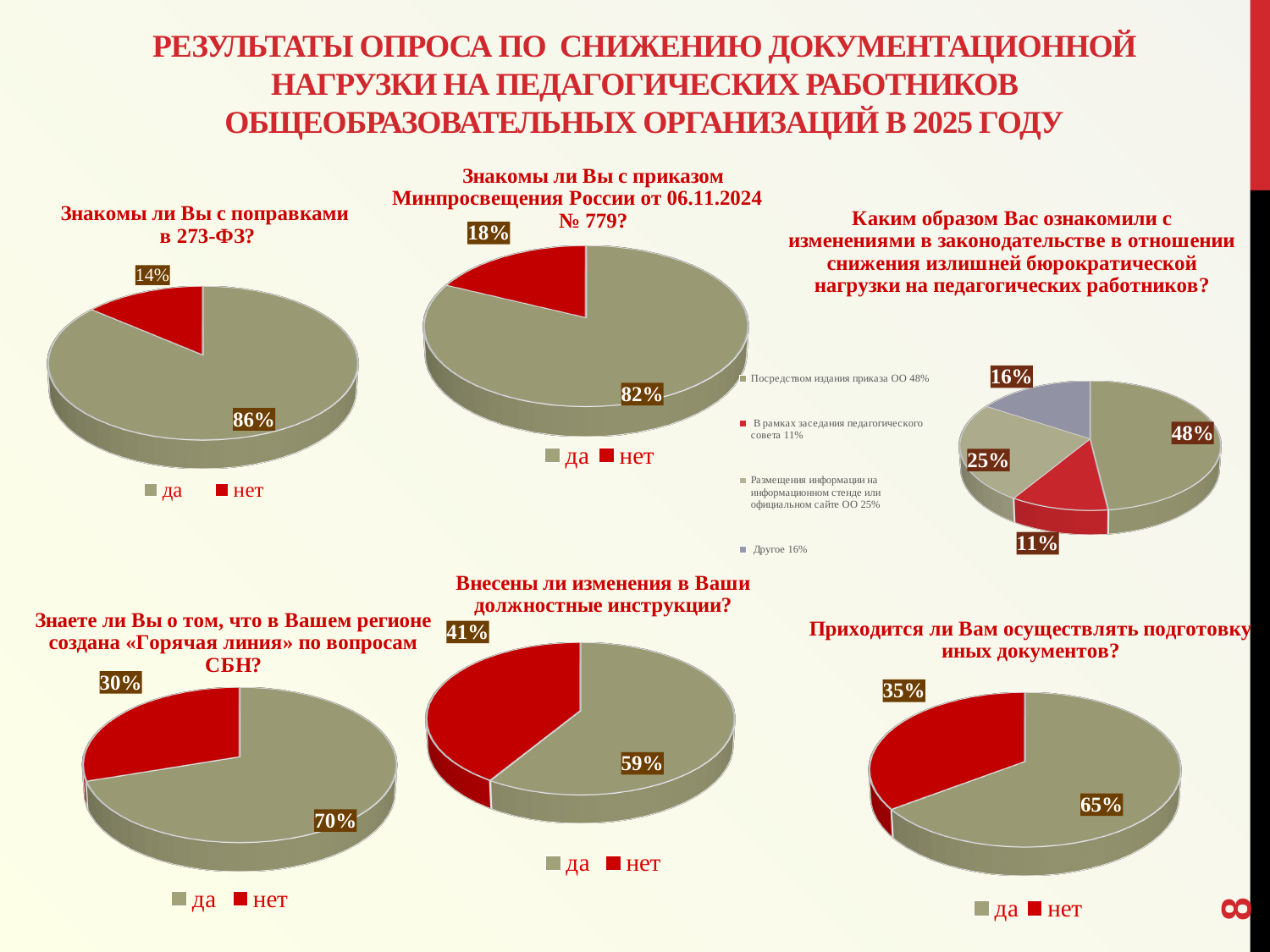
In the chart 'Знакомы ли Вы с приказом Минпросвещения России от 06.11.2024 № 779?', what share of respondents answered 'нет'? 18% In the chart 'Знакомы ли Вы с поправками в 273-ФЗ?', what share of respondents answered 'да'? 86% In the chart 'Приходится ли Вам осуществлять подготовку иных документов?', which answer has the larger share, 'да' or 'нет'? да What type of chart is used for 'Внесены ли изменения в Ваши должностные инструкции?'? Pie chart In the chart 'Внесены ли изменения в Ваши должностные инструкции?', what is the difference between the 'да' and 'нет' shares? 18% In the chart 'Приходится ли Вам осуществлять подготовку иных документов?', what share answered 'нет'? 35% In the chart 'Каким образом Вас ознакомили с изменениями в законодательстве...', which category has the largest share? Посредством издания приказа ОО How many entries does the legend of the chart 'Знакомы ли Вы с поправками в 273-ФЗ?' list? 2 How many categories does the chart 'Каким образом Вас ознакомили с изменениями в законодательстве...' show? 4 In the chart 'Каким образом Вас ознакомили с изменениями в законодательстве...', what is the share for 'Другое'? 16% In the chart 'Каким образом Вас ознакомили с изменениями в законодательстве...', which category has the smallest share? В рамках заседания педагогического совета In the chart 'Знаете ли Вы о том, что в Вашем регионе создана «Горячая линия» по вопросам СБН?', what share answered 'нет'? 30%